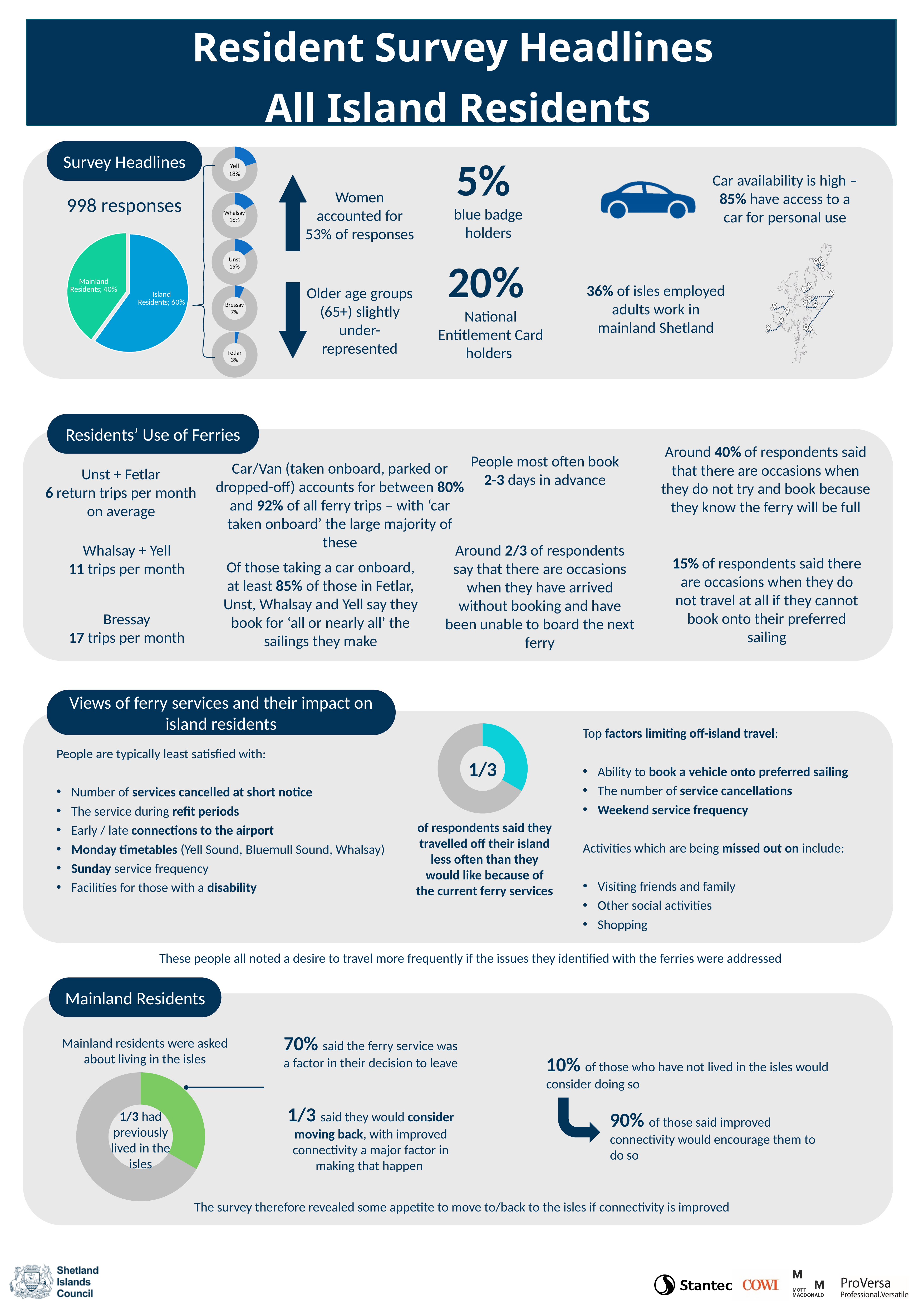
What type of chart shows the split between Island Residents and Mainland Residents? Pie chart In the small donut charts next to the pie chart, which island has the lowest percentage? Fetlar In the small donut charts next to the pie chart, what percentage is shown for Yell? 18% In the pie chart under 'Survey Headlines', what share of responses came from Mainland Residents? 40% In the pie chart under 'Survey Headlines', which slice is larger, Island Residents or Mainland Residents? Island Residents In the small donut charts next to the pie chart, which island has the highest percentage? Yell How many small island donut charts are shown next to the pie chart under 'Survey Headlines'? 5 How many slices does the pie chart under 'Survey Headlines' have? 2 In the donut chart under 'Mainland Residents', what fraction had previously lived in the isles? 1/3 In the pie chart under 'Survey Headlines', what share of responses came from Island Residents? 60% In the small donut charts next to the pie chart, what percentage is shown for Fetlar? 3% In the pie chart under 'Survey Headlines', what is the difference in percentage points between Island Residents and Mainland Residents? 20